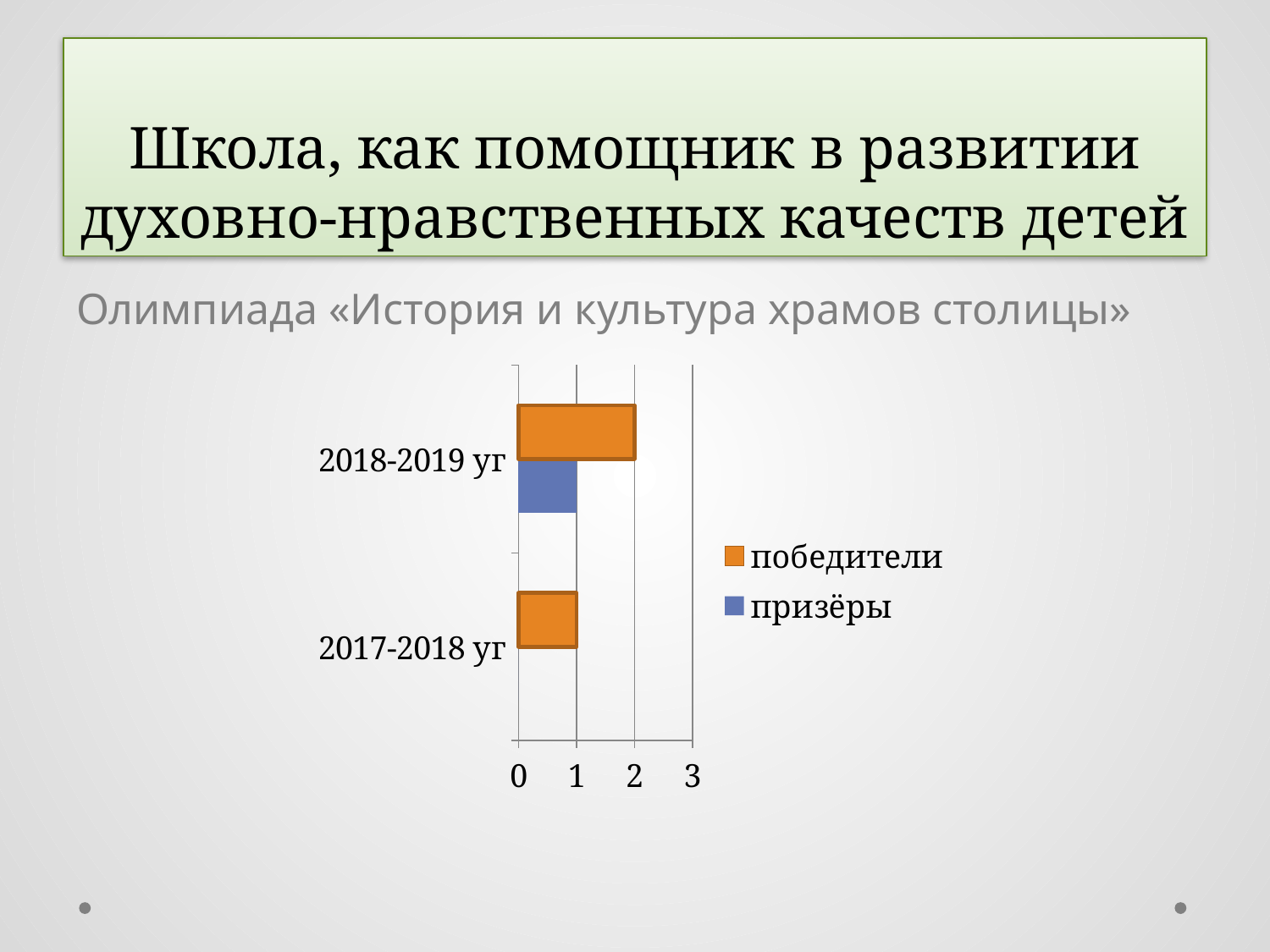
Which school year has the higher value for победители? 2018-2019 уг What is the value for призёры in 2018-2019 уг? 1 How many series does the legend list? 2 Which is larger in 2018-2019 уг: победители or призёры? победители What is the name of the olympiad given in the chart's subtitle? «История и культура храмов столицы» What is the difference between победители and призёры in 2018-2019 уг? 1 How many categories (school years) are shown on the chart? 2 What kind of chart is shown on the slide? bar chart What is the value for победители in 2018-2019 уг? 2 Which series is shown in orange in the legend? победители What is the value for победители in 2017-2018 уг? 1 Is the value for победители in 2018-2019 уг greater or less than 3? less